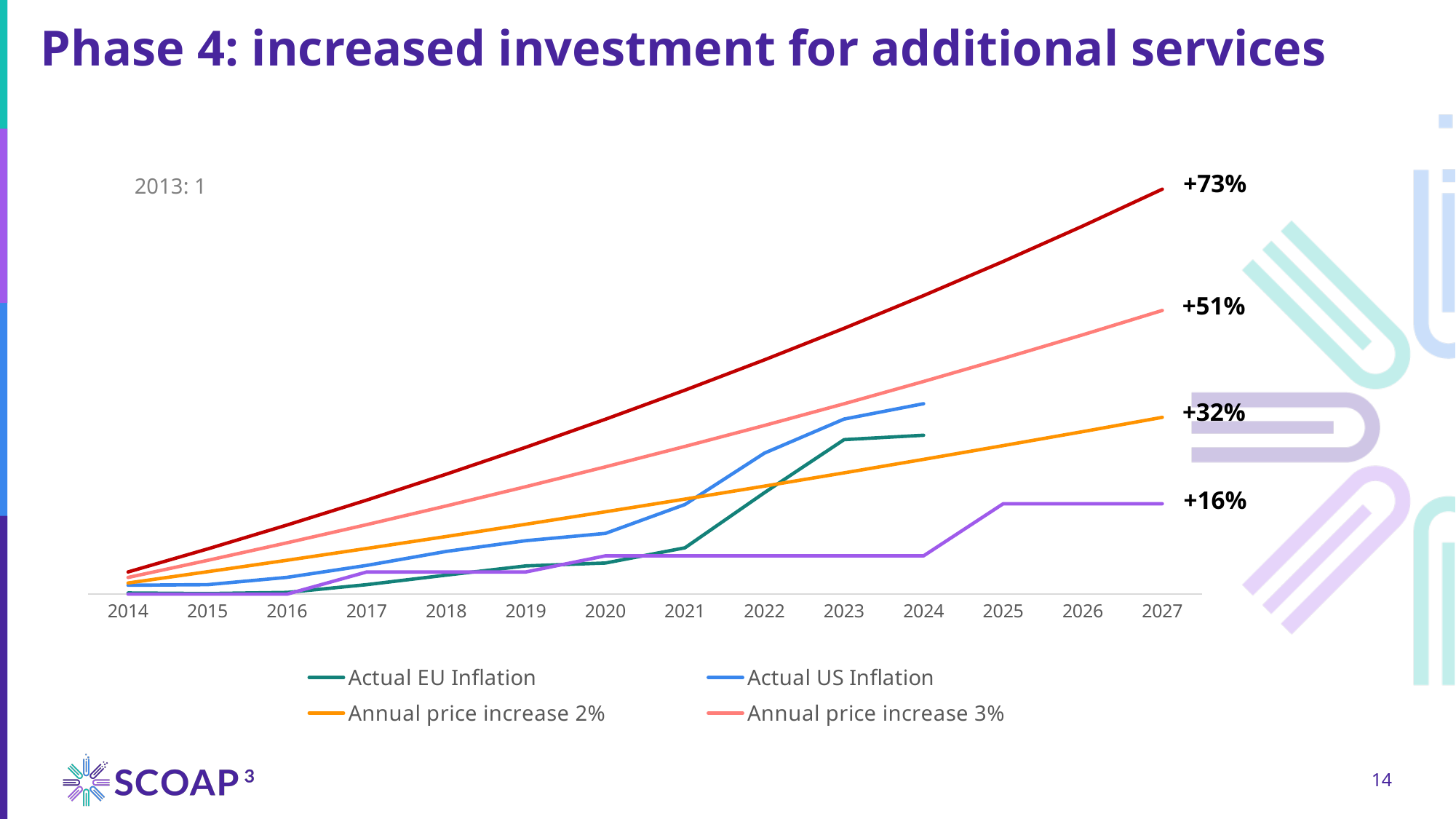
What is the highest value labelled at the right end of the chart? +73% How many series does the legend list? 4 In 2024, which is higher, Actual US Inflation or Actual EU Inflation? Actual US Inflation How many years are shown on the x axis? 14 What is the difference between the labelled 2027 values of the Annual price increase 3% line and the Annual price increase 2% line? 19 percentage points What value is labelled at the 2027 end of the Annual price increase 3% line? +51% Which line ends higher in 2027, Annual price increase 3% or Annual price increase 2%? Annual price increase 3% What is the first year shown on the x axis? 2014 What value is labelled at the 2027 end of the Annual price increase 2% line? +32% What is the lowest value labelled at the right end of the chart? +16% Does the Annual price increase 2% line rise or fall from 2014 to 2027? rise What kind of chart is shown on the slide? line chart